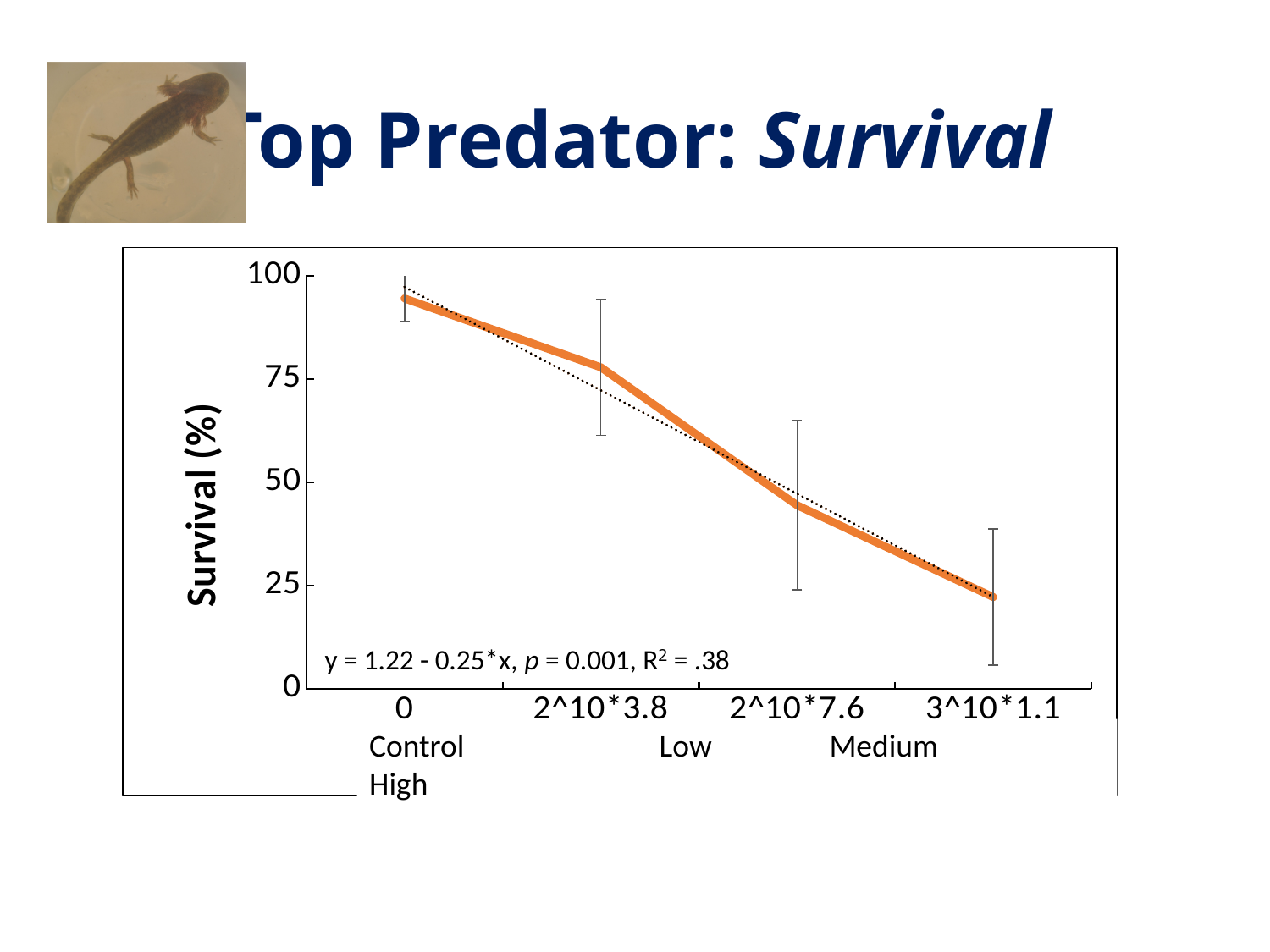
Is the survival value for the Low treatment greater or less than 75? greater What R² value is printed on the chart? .38 Do the survival values rise or fall as the x axis moves from Control to High? fall What is the label on the y axis? Survival (%) Is the survival value for the Control treatment greater or less than 75? greater Is the survival value for the Medium treatment greater or less than 50? less Which has higher survival, the Low treatment or the Medium treatment? Low How many data points are plotted on the line? 4 Which treatment has the lowest survival? High (3^10*1.1) What kind of chart is shown on the slide? line chart Which treatment has the highest survival? Control (0)